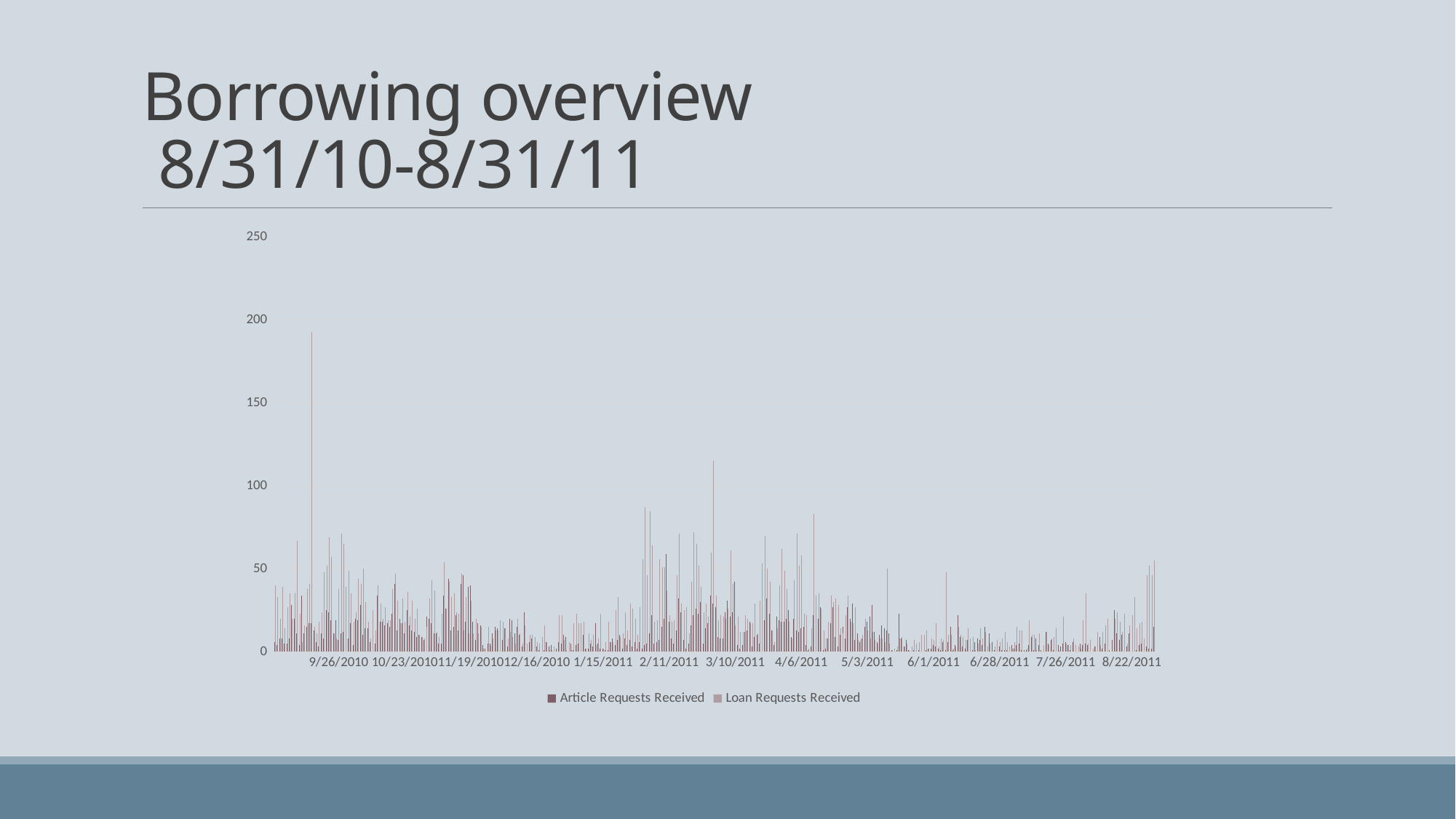
How many date labels are printed along the chart's horizontal axis? 13 Are the bars around 6/28/2011 generally taller or shorter than the bars around 9/26/2010? shorter What is the last date label printed on the chart's horizontal axis? 8/22/2011 What is the first date label printed on the chart's horizontal axis? 9/26/2010 What are the two series named in the chart legend? Article Requests Received and Loan Requests Received Do the bar heights generally rise or fall from the start of the period to the end of the period? fall What is the title of the slide containing the chart? Borrowing overview 8/31/10-8/31/11 What is the highest value shown on the chart's vertical axis? 250 Is the tallest bar in the chart greater or less than 150? greater Is the tallest bar in the chart greater or less than 200? less How many series does the chart legend list? 2 What kind of chart is shown on the slide? bar chart